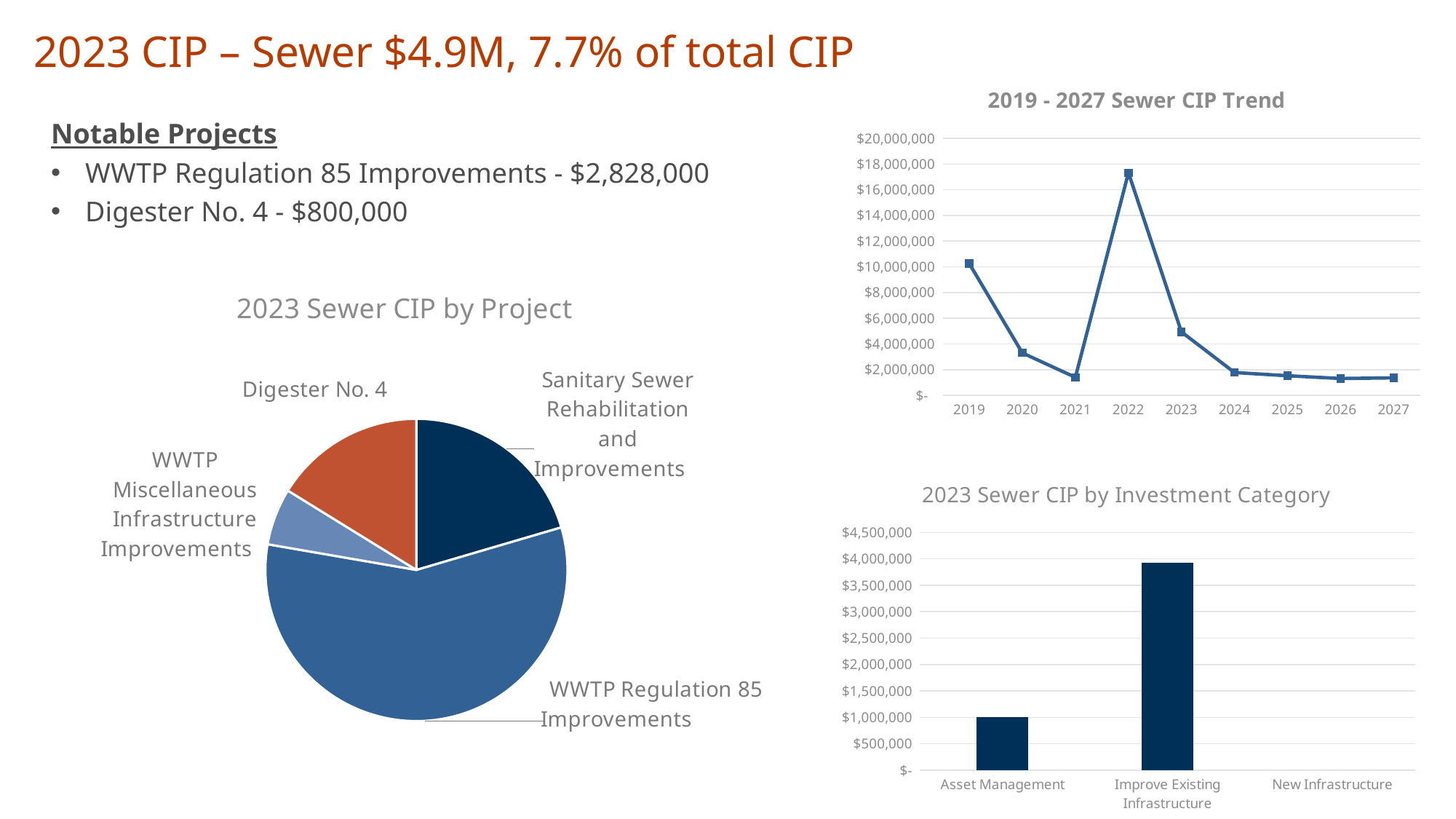
In the "2019 - 2027 Sewer CIP Trend" chart, is the value for 2023 greater or less than $6,000,000? less In the "2023 Sewer CIP by Project" pie chart, which project has the largest slice? WWTP Regulation 85 Improvements What kind of chart is the "2023 Sewer CIP by Investment Category" chart? Bar chart What kind of chart is the "2019 - 2027 Sewer CIP Trend" chart? Line chart How many years are plotted in the "2019 - 2027 Sewer CIP Trend" chart? 9 In the "2023 Sewer CIP by Investment Category" chart, is the value for Improve Existing Infrastructure greater or less than $3,500,000? greater What kind of chart is the "2023 Sewer CIP by Project" chart? Pie chart In the "2019 - 2027 Sewer CIP Trend" chart, is the value for 2022 greater or less than $16,000,000? greater In the "2019 - 2027 Sewer CIP Trend" chart, which year has the highest value? 2022 How many slices does the "2023 Sewer CIP by Project" pie chart have? 4 In the "2019 - 2027 Sewer CIP Trend" chart, do the values rise or fall from 2022 to 2027? fall In the "2023 Sewer CIP by Project" pie chart, which project has the smallest slice? WWTP Miscellaneous Infrastructure Improvements